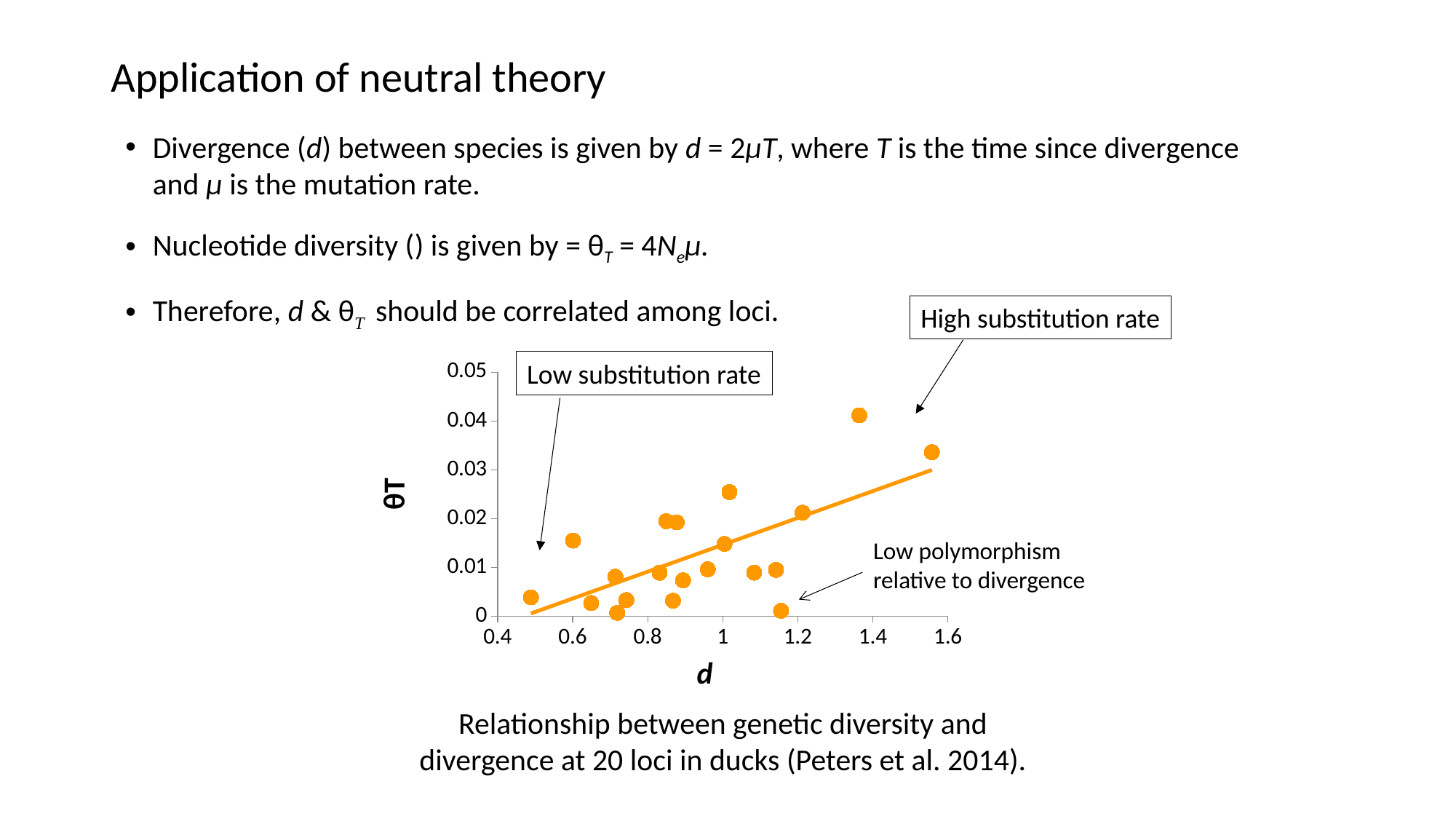
Does θT generally rise or fall as d increases along the x axis? Rise Is the d value of the point with the highest θT greater or less than 1.2? greater Is the θT value of the rightmost point (largest d) greater or less than 0.03? greater How many data points are plotted in the scatter plot? 20 Is the θT value of the point annotated 'Low polymorphism relative to divergence' greater or less than 0.01? less What is the highest value shown on the y axis of the chart? 0.05 What kind of chart is shown on the slide? Scatter plot Which has the larger θT: the point with the largest d or the point with the smallest d? The point with the largest d What is the label of the y axis of the chart? θT Is the point with the highest θT the same point as the one with the largest d? No What is the label of the x axis of the chart? d